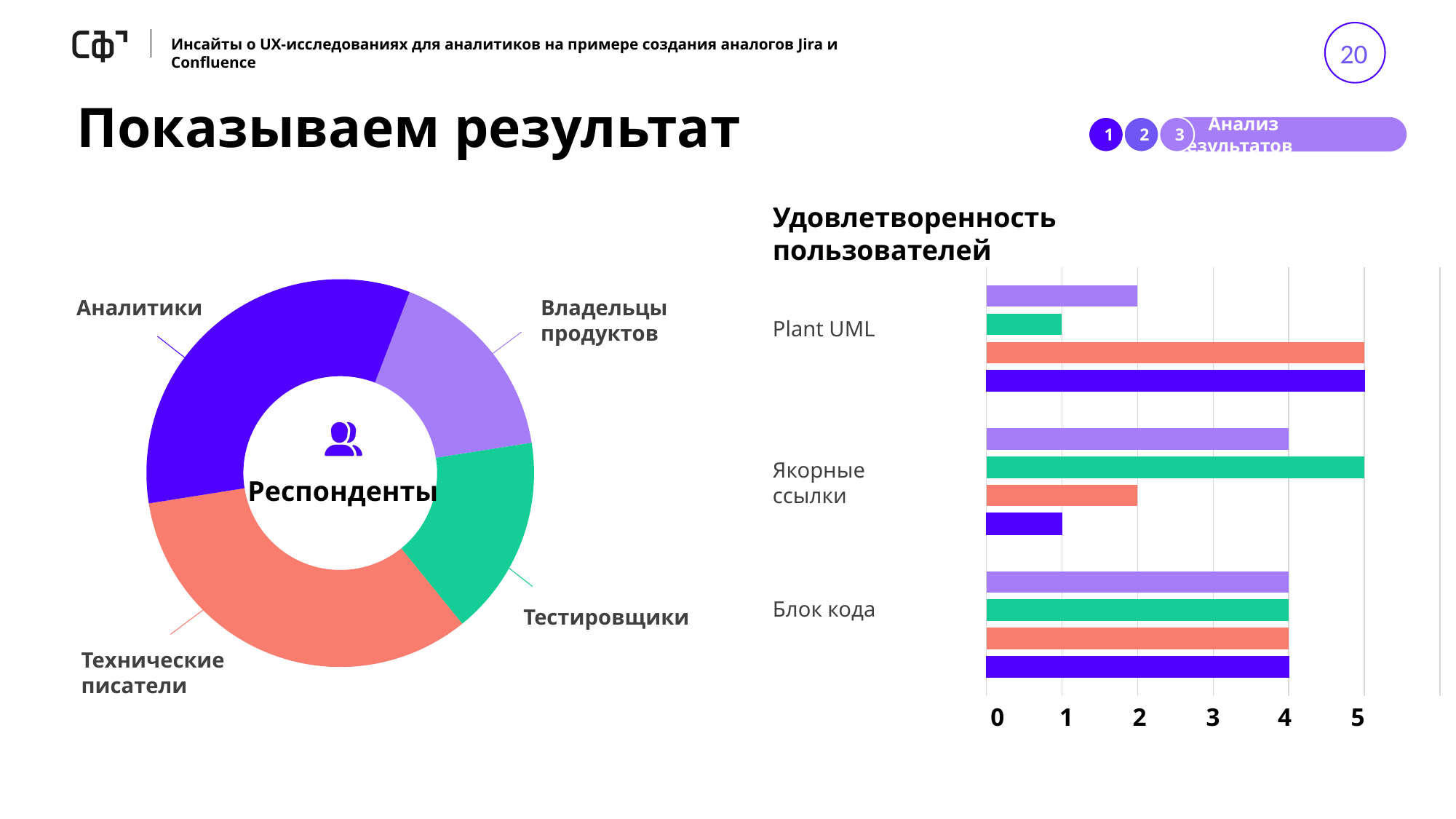
In the "Респонденты" donut chart, which group is shown in green? Тестировщики In the "Удовлетворенность пользователей" chart, is the light purple bar for Plant UML greater or less than 3? less How many categories are shown on the "Удовлетворенность пользователей" chart? 3 In the "Удовлетворенность пользователей" chart, what is the value of the green bar for Plant UML? 1 What kind of chart is "Удовлетворенность пользователей"? Bar chart In the "Респонденты" donut chart, which group has the largest slice? Технические писатели and Аналитики (tied, equal slices) In the "Удовлетворенность пользователей" chart, what is the value of the coral bar for Якорные ссылки? 2 What kind of chart is the "Респонденты" chart on the left? Donut (pie) chart How many respondent groups does the "Респонденты" donut chart show? 4 In the "Удовлетворенность пользователей" chart, which is larger for Plant UML: the green bar or the coral bar? The coral bar In the "Удовлетворенность пользователей" chart, what is the difference between the green bar and the dark purple bar for Якорные ссылки? 4 In the "Удовлетворенность пользователей" chart, what is the value of the dark purple bar for Блок кода? 4